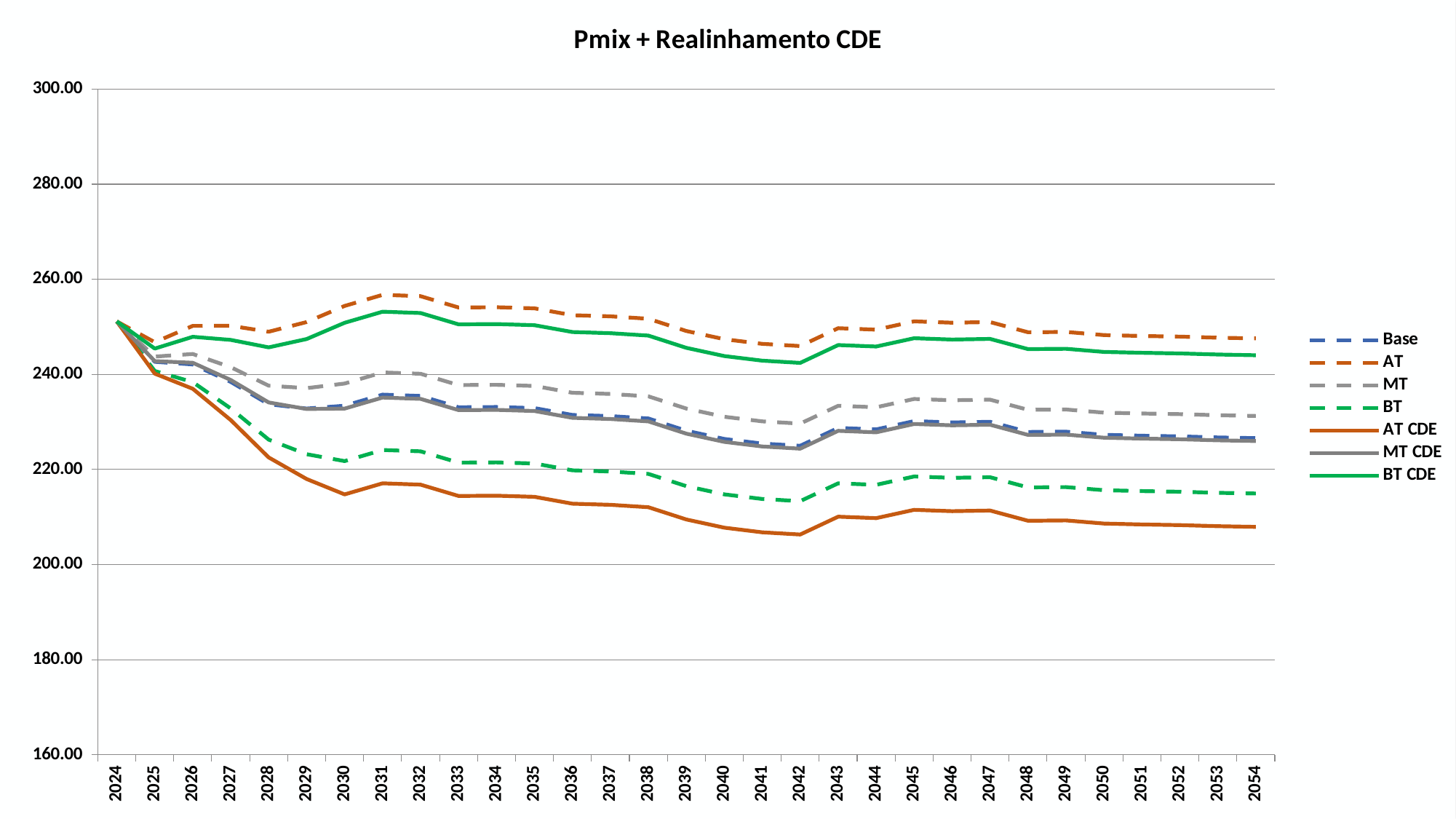
What kind of chart is shown on the slide? line chart Which series has the highest value in 2054? AT Is the value for AT CDE in 2042 greater or less than 220? less Which series has the lowest value in 2054? AT CDE How many years are shown along the x axis? 31 Which series is drawn as a solid green line? BT CDE Does the AT CDE series rise or fall from 2024 to 2054? fall In 2040, which is larger: BT CDE or MT? BT CDE Is the value for AT in 2031 greater or less than 240? greater How many series does the legend list? 7 Is the value for BT in 2054 greater or less than 220? less What is the title of the chart? Pmix + Realinhamento CDE